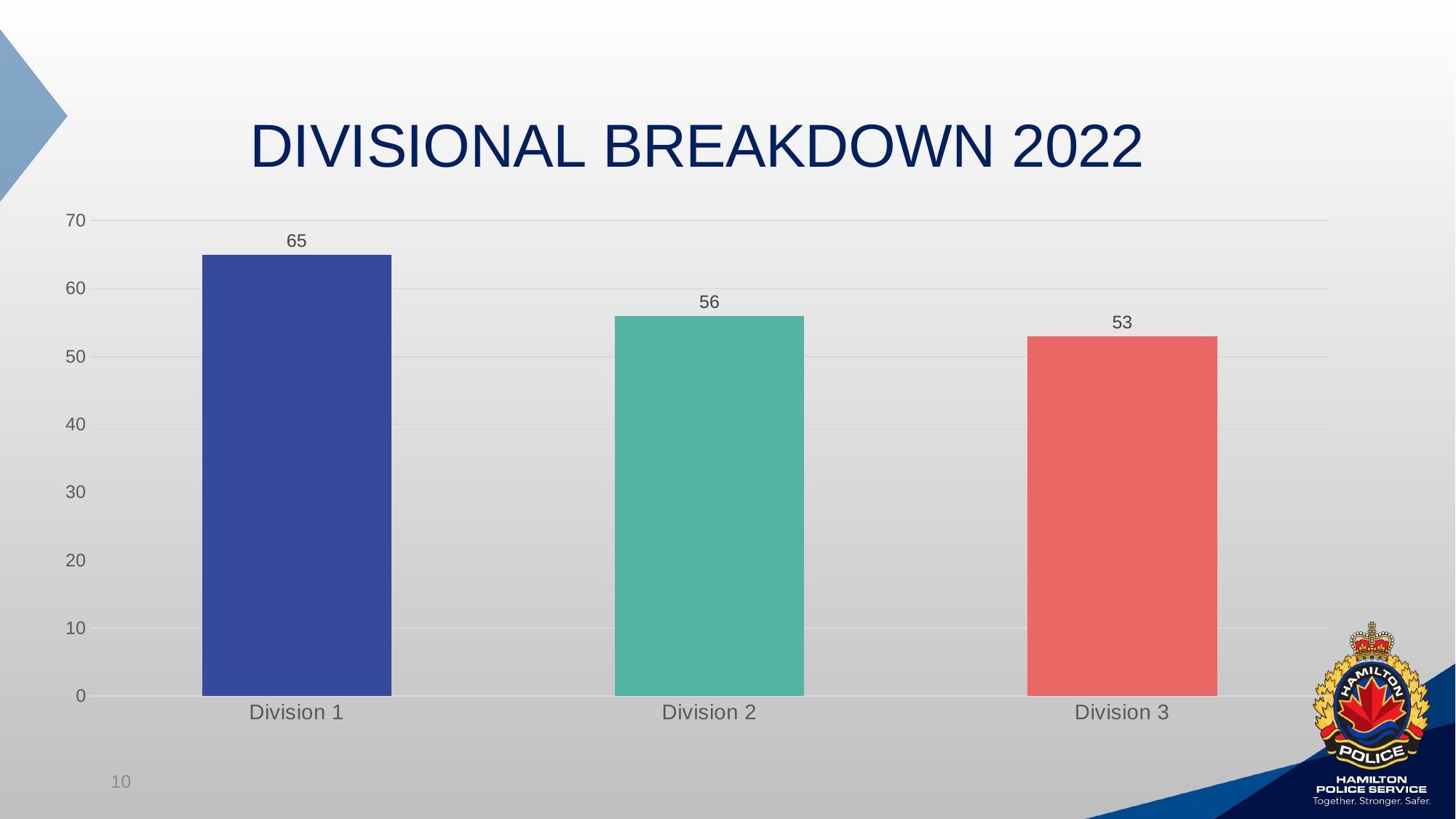
What is the difference between the values for Division 2 and Division 3? 3 What is the value for Division 1? 65 Is the value for Division 2 greater or less than 60? less What is the title of the chart? DIVISIONAL BREAKDOWN 2022 What is the value for Division 3? 53 What is the difference between the values for Division 1 and Division 3? 12 Which is larger, the value for Division 1 or the value for Division 2? Division 1 What kind of chart is shown on the slide? bar chart Which division has the highest value? Division 1 What is the value for Division 2? 56 Which division has the lowest value? Division 3 How many divisions are shown in the chart? 3